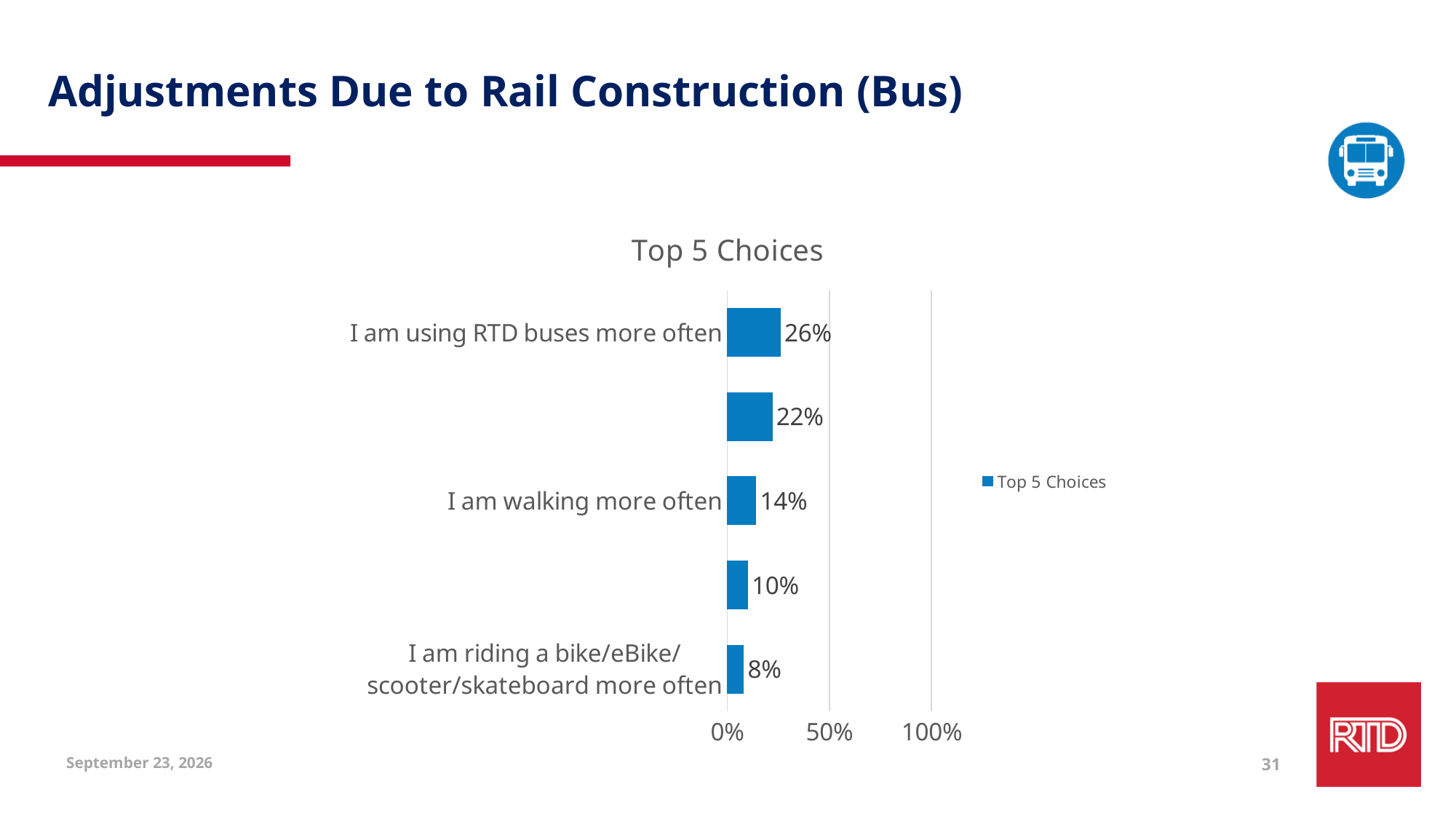
Is the value for "I am using RTD buses more often" greater or less than 50%? less Which category has the lowest value in the chart? I am riding a bike/eBike/scooter/skateboard more often Which is larger: the value for "I am walking more often" or for "I am riding a bike/eBike/scooter/skateboard more often"? I am walking more often What percentage is shown for "I am riding a bike/eBike/scooter/skateboard more often"? 8% How many bars are plotted in the chart? 5 Which category has the highest value in the chart? I am using RTD buses more often What is the difference between the values for "I am walking more often" and "I am riding a bike/eBike/scooter/skateboard more often"? 6% What percentage of respondents said "I am using RTD buses more often"? 26% What value is shown for "I am walking more often"? 14% What is the difference between the values for "I am using RTD buses more often" and "I am walking more often"? 12% What is the title of the chart? Top 5 Choices What type of chart is shown on the slide? bar chart